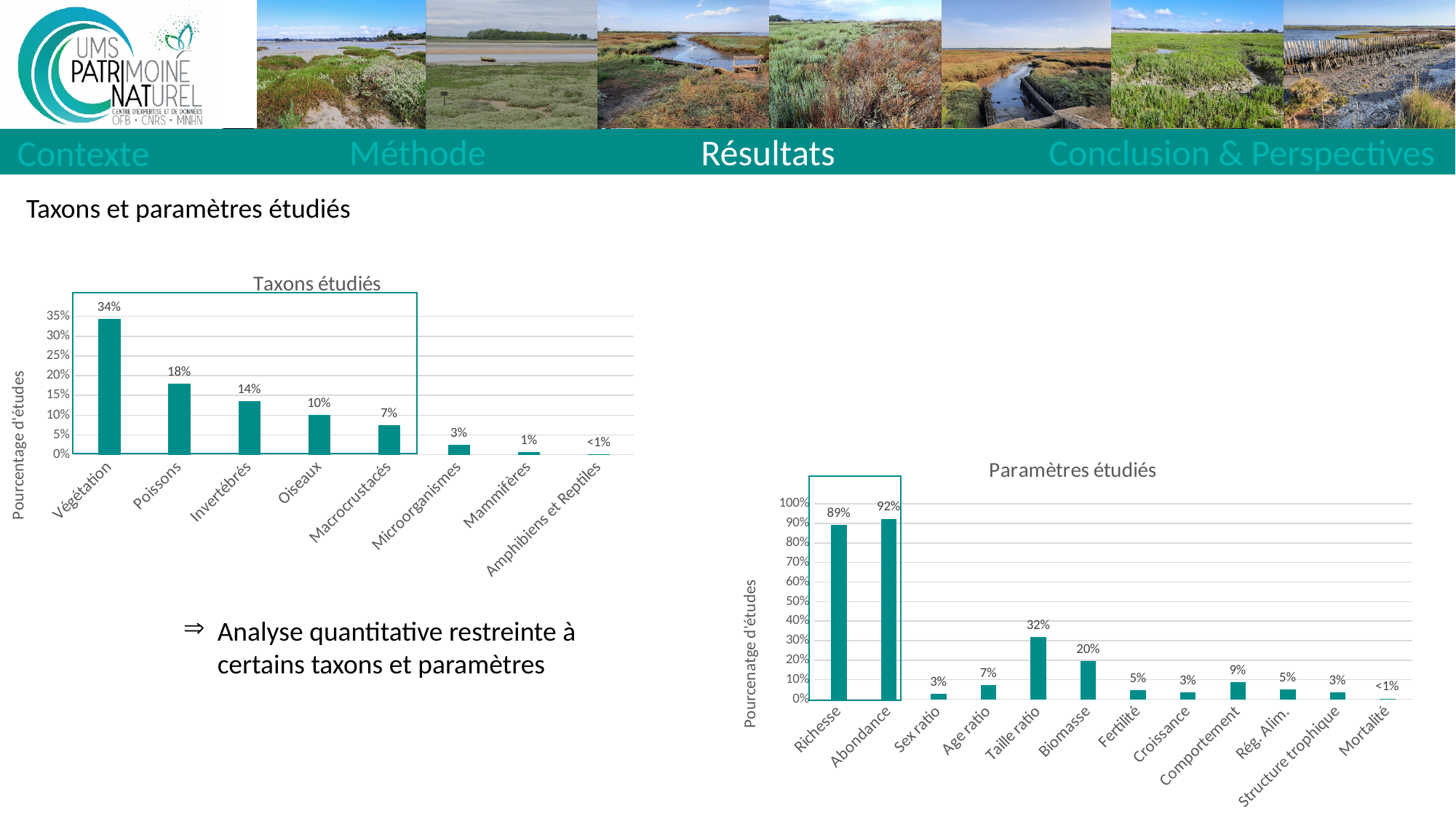
In the 'Taxons étudiés' chart, what is the value for Végétation? 34% In the 'Paramètres étudiés' chart, what is the difference between Abondance and Richesse? 3% In the 'Taxons étudiés' chart, what is the difference between Poissons and Invertébrés? 4% In the 'Taxons étudiés' chart, how many categories are shown on the x axis? 8 What type of chart is the 'Paramètres étudiés' chart? Bar chart In the 'Taxons étudiés' chart, which category has the highest value? Végétation In the 'Paramètres étudiés' chart, what is the value for Taille ratio? 32% In the 'Paramètres étudiés' chart, how many categories are shown on the x axis? 12 In the 'Taxons étudiés' chart, what is the value for Oiseaux? 10% In the 'Taxons étudiés' chart, which is larger, Macrocrustacés or Microorganismes? Macrocrustacés In the 'Paramètres étudiés' chart, what is the value for Abondance? 92% In the 'Paramètres étudiés' chart, which category has the highest value? Abondance